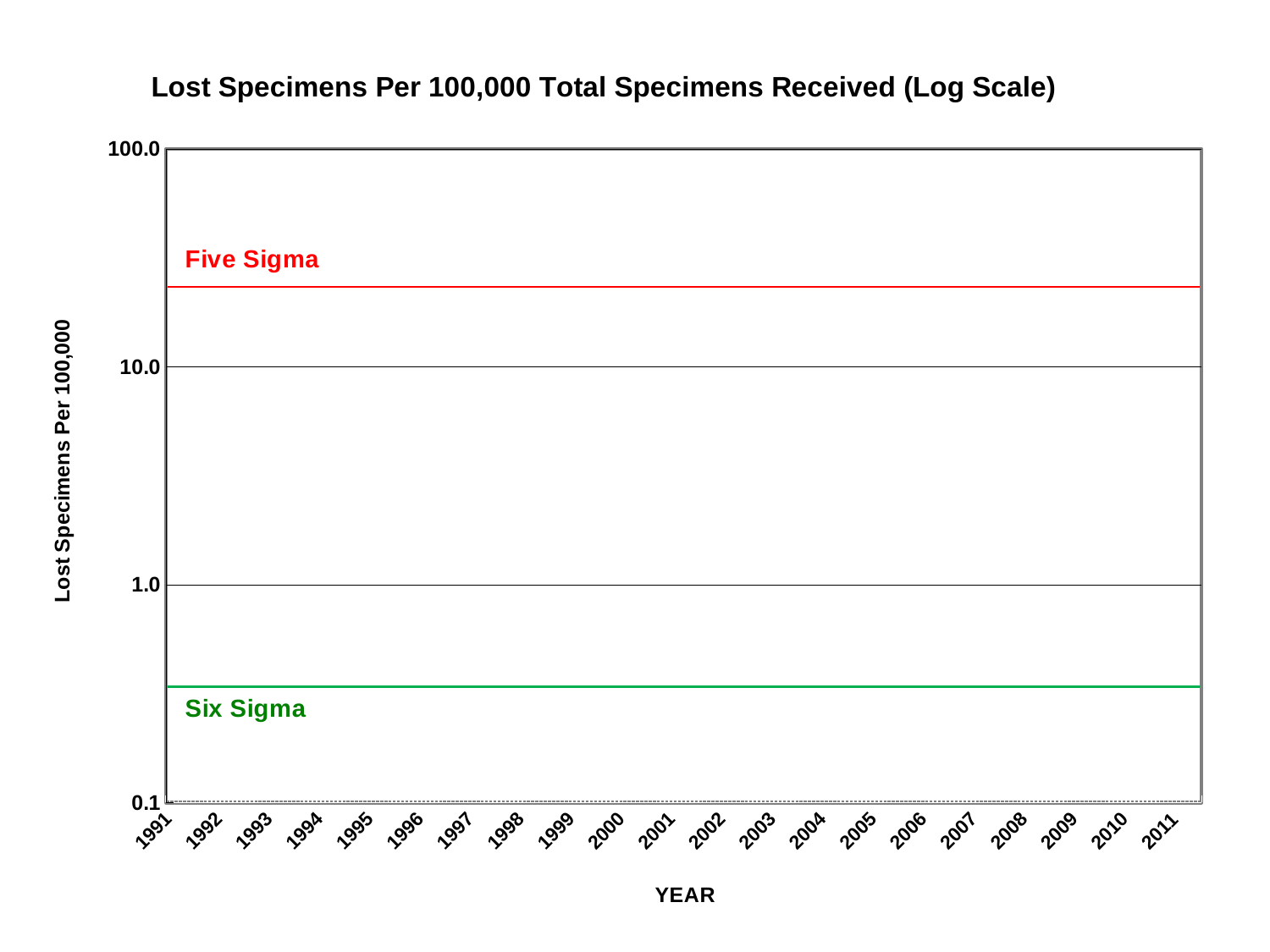
Is the Five Sigma line greater or less than 10.0? greater How many years are labelled along the x axis? 21 What is the last year shown on the x axis? 2011 Is the Five Sigma line greater or less than 100.0? less What is the label of the y axis? Lost Specimens Per 100,000 What kind of chart is shown on the slide? line chart Is the Six Sigma line greater or less than 0.1? greater Does the Five Sigma line rise, fall or stay flat from 1991 to 2011? stays flat Which line is higher on the chart, Five Sigma or Six Sigma? Five Sigma What is the title of the chart? Lost Specimens Per 100,000 Total Specimens Received (Log Scale) What is the first year shown on the x axis? 1991